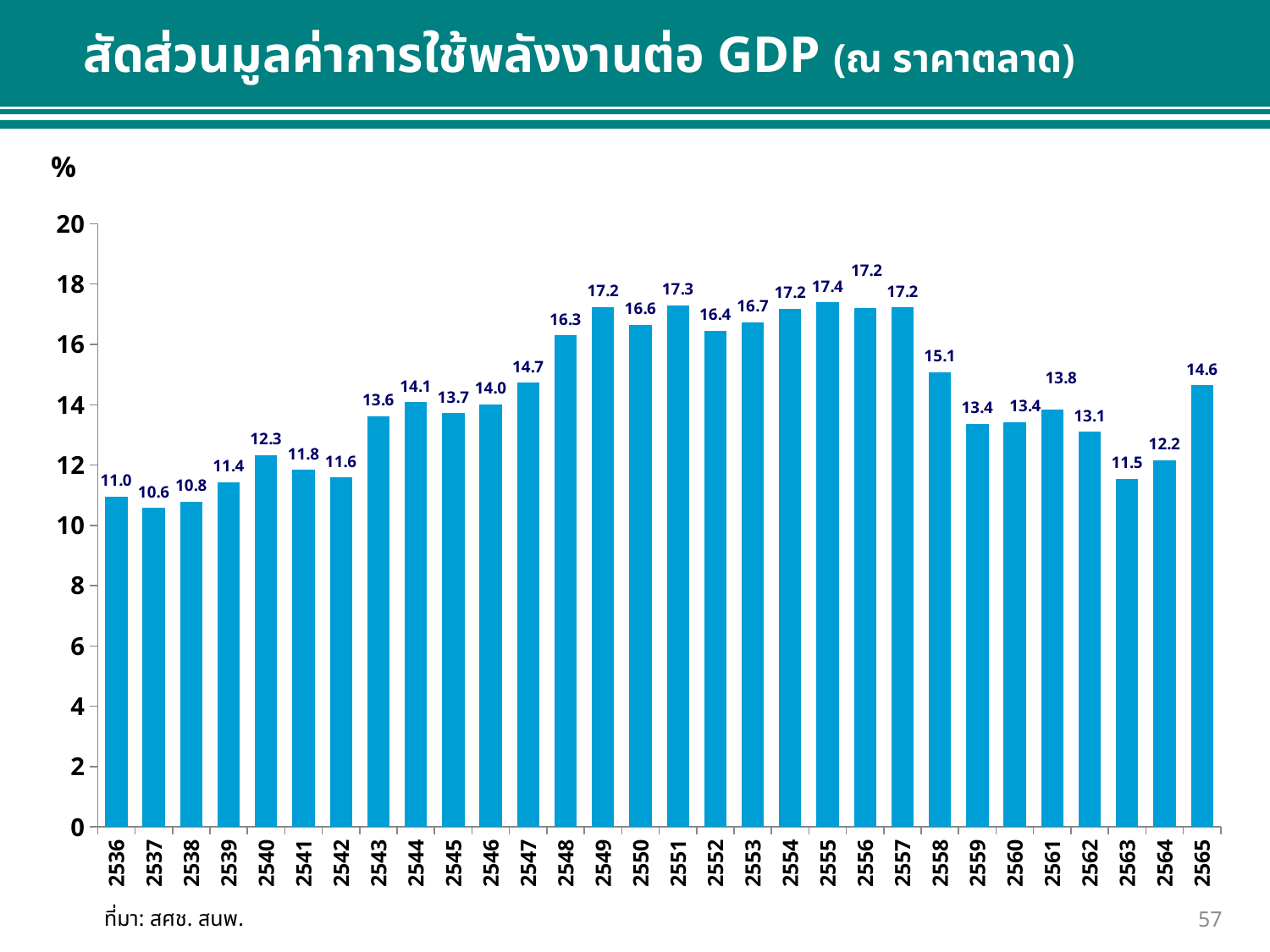
What unit is shown on the y axis? % What is the difference between the values for 2555 and 2537? 6.8 Which year has the lowest value? 2537 What is the value for 2565? 14.6 Which year has the highest value? 2555 What is the value for 2540? 12.3 How many years are shown on the x axis? 30 What is the value for 2558? 15.1 What is the difference between the values for 2565 and 2564? 2.4 Is the value for 2551 greater or less than 16? greater What kind of chart is this? bar chart Which is larger, the value for 2548 or the value for 2563? 2548